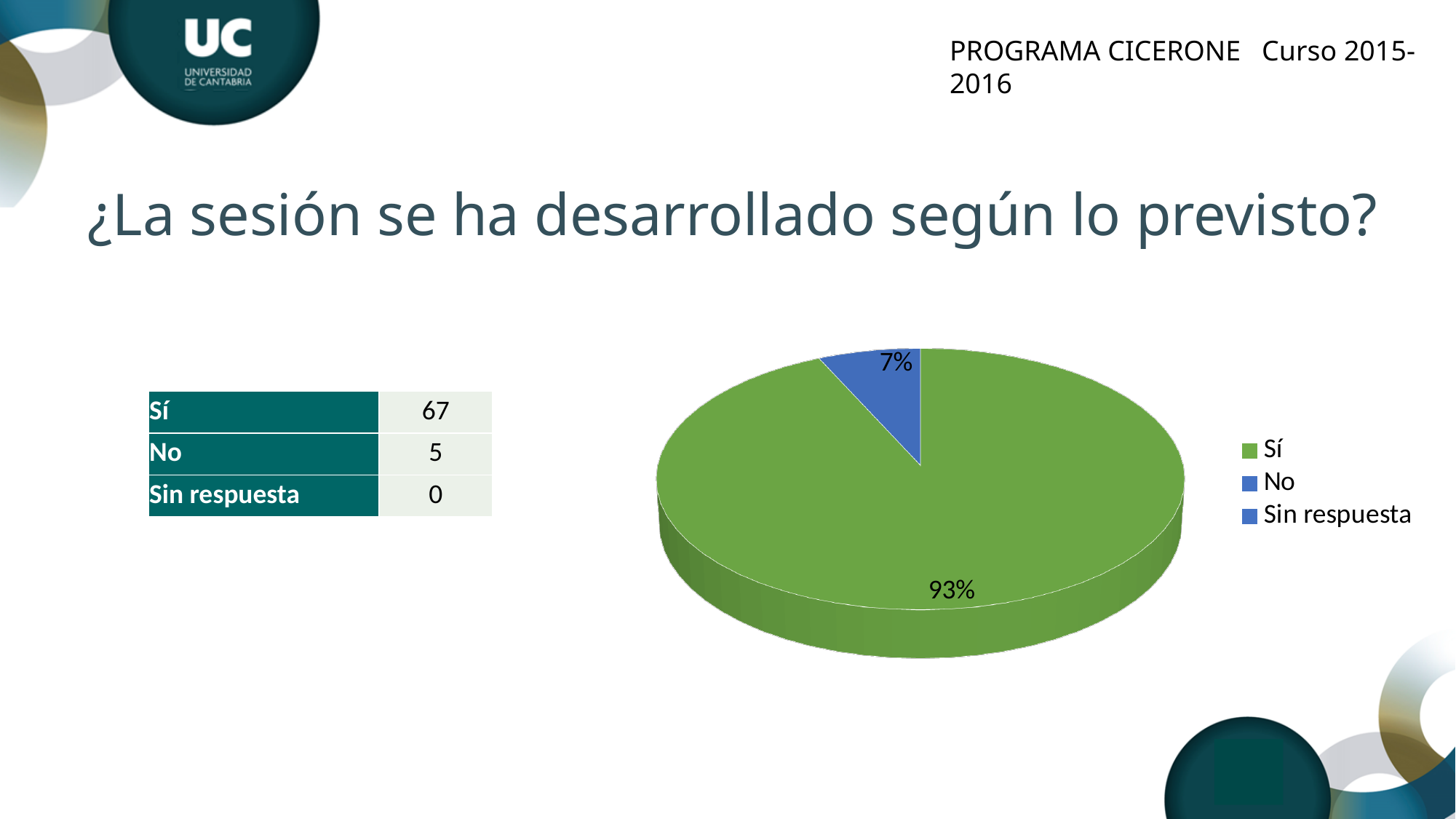
Which is larger, the 'Sí' slice or the 'No' slice? Sí What colour is the 'Sí' slice in the pie chart? green What percentage of the pie does the 'No' slice represent? 7% How many entries does the legend list? 3 What is the difference in percentage points between the 'Sí' slice and the 'No' slice? 86 What colour is the 'No' slice in the pie chart? blue What percentage of the pie does the 'Sí' slice represent? 93% Which category has the largest slice of the pie? Sí According to the table next to the chart, how many responses were 'Sin respuesta'? 0 What kind of chart is shown on the slide? pie chart According to the table next to the chart, how many responses were 'No'? 5 According to the table next to the chart, how many responses were 'Sí'? 67